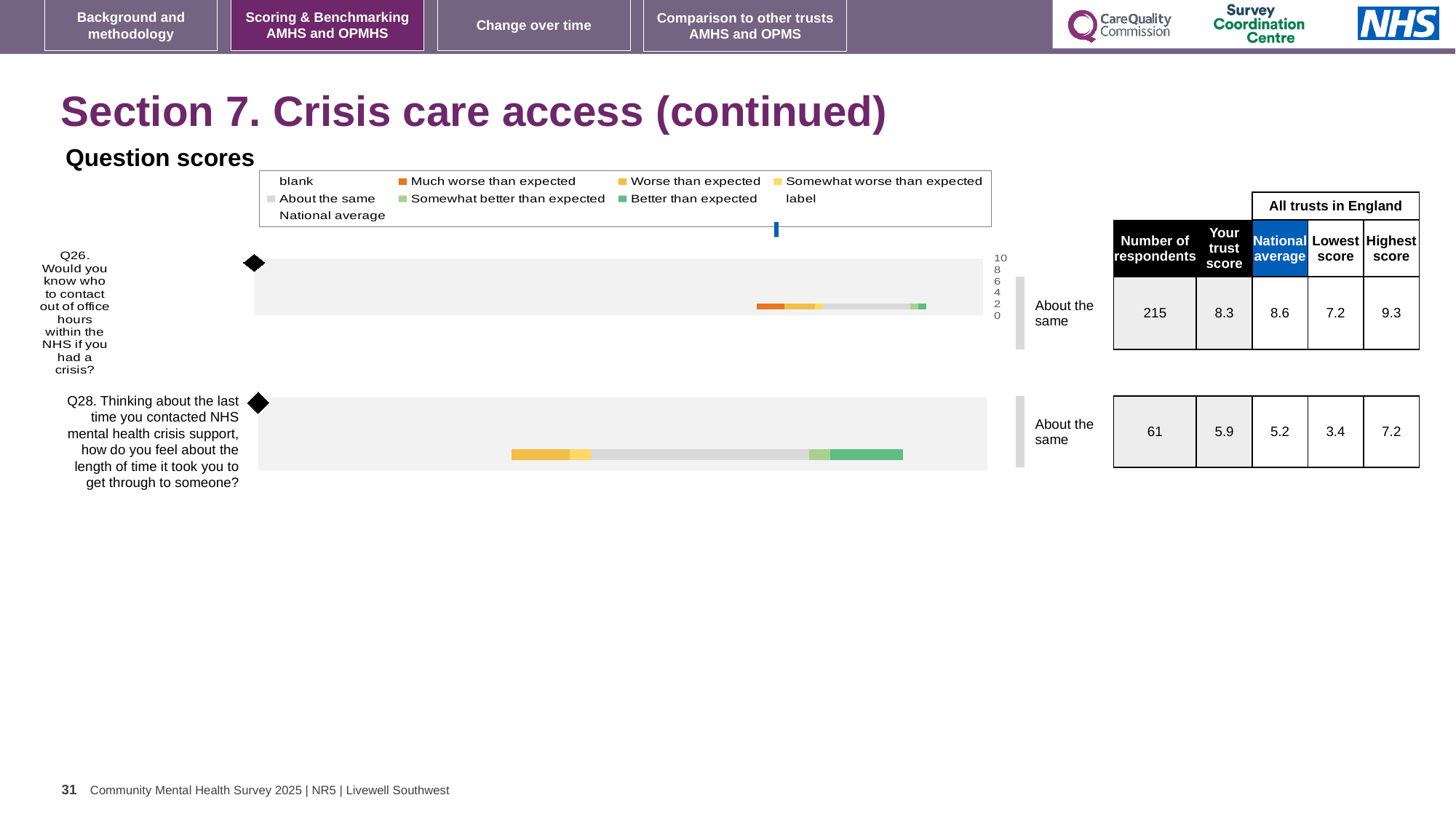
What kind of chart is used to show the question scores for Q26 and Q28? bar chart What benchmark category is shown next to the Q28 bar? About the same Which question has the higher 'Your trust score', Q26 or Q28? Q26 For Q26, which is larger: the trust score or the national average? national average Which question has more respondents, Q26 or Q28? Q26 For Q28, how much higher is the trust score than the national average? 0.7 What is the 'Your trust score' value for Q26? 8.3 How many questions are plotted in the question scores chart? 2 How many respondents answered Q28? 61 What is the highest score among all trusts in England for Q28? 7.2 What is the national average score for Q26? 8.6 For Q26, what is the difference between the highest score and the lowest score among all trusts in England? 2.1